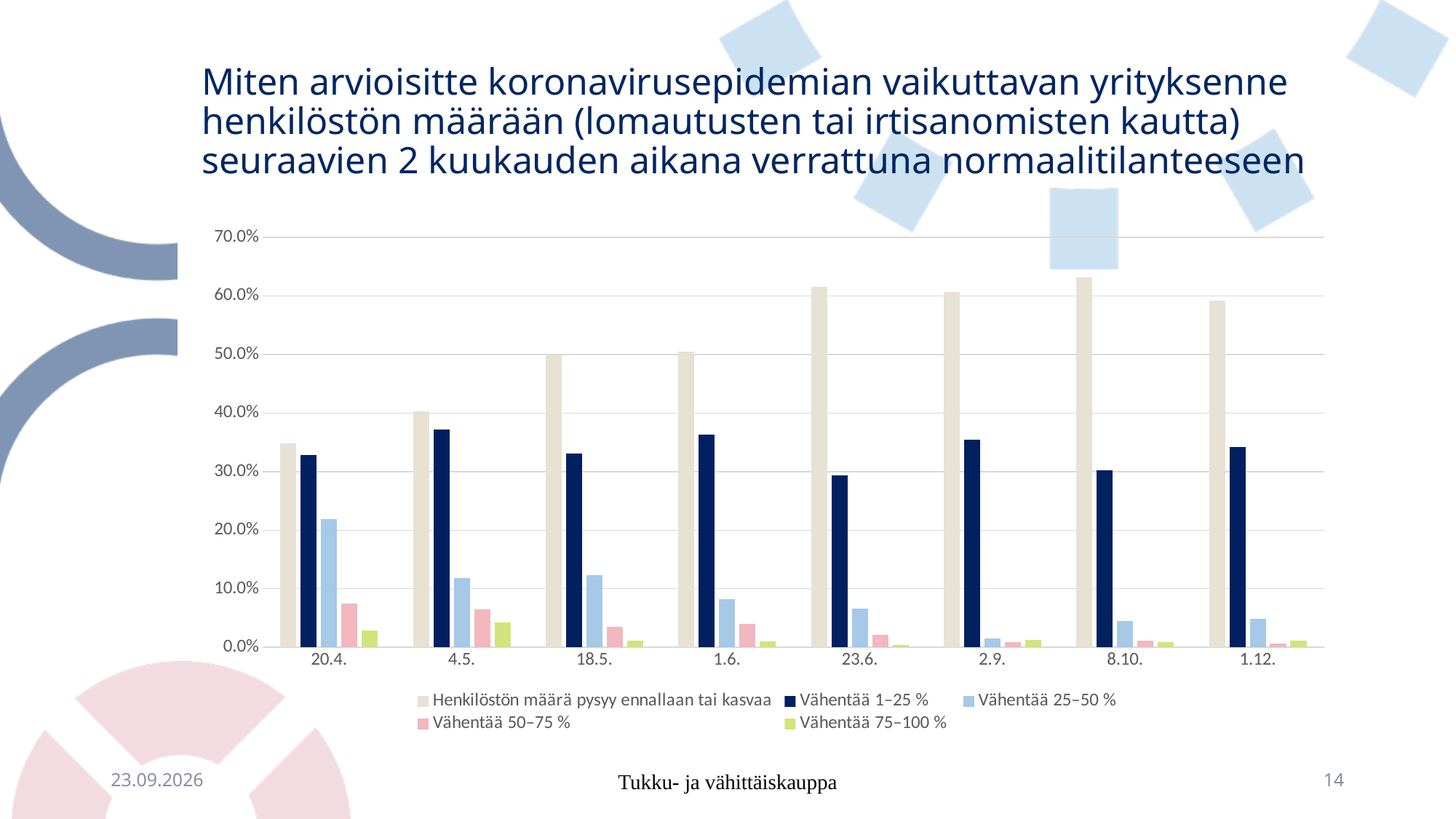
Does the value for 'Vähentää 25–50 %' generally rise or fall from 20.4. to 1.12.? fall On which date is the value for 'Henkilöstön määrä pysyy ennallaan tai kasvaa' lowest? 20.4. Is the value for 'Vähentää 25–50 %' on 20.4. greater or less than 20.0%? greater On which date is the value for 'Vähentää 25–50 %' lowest? 2.9. How many dates (categories) are shown on the x axis? 8 How many series does the legend list? 5 On which date is the value for 'Vähentää 25–50 %' highest? 20.4. Is the value for 'Henkilöstön määrä pysyy ennallaan tai kasvaa' on 8.10. greater or less than 60.0%? greater On 23.6., which is larger: 'Henkilöstön määrä pysyy ennallaan tai kasvaa' or 'Vähentää 1–25 %'? Henkilöstön määrä pysyy ennallaan tai kasvaa Is the value for 'Henkilöstön määrä pysyy ennallaan tai kasvaa' on 20.4. greater or less than 40.0%? less What kind of chart is shown on the slide? bar chart On which date is the value for 'Vähentää 75–100 %' highest? 4.5.